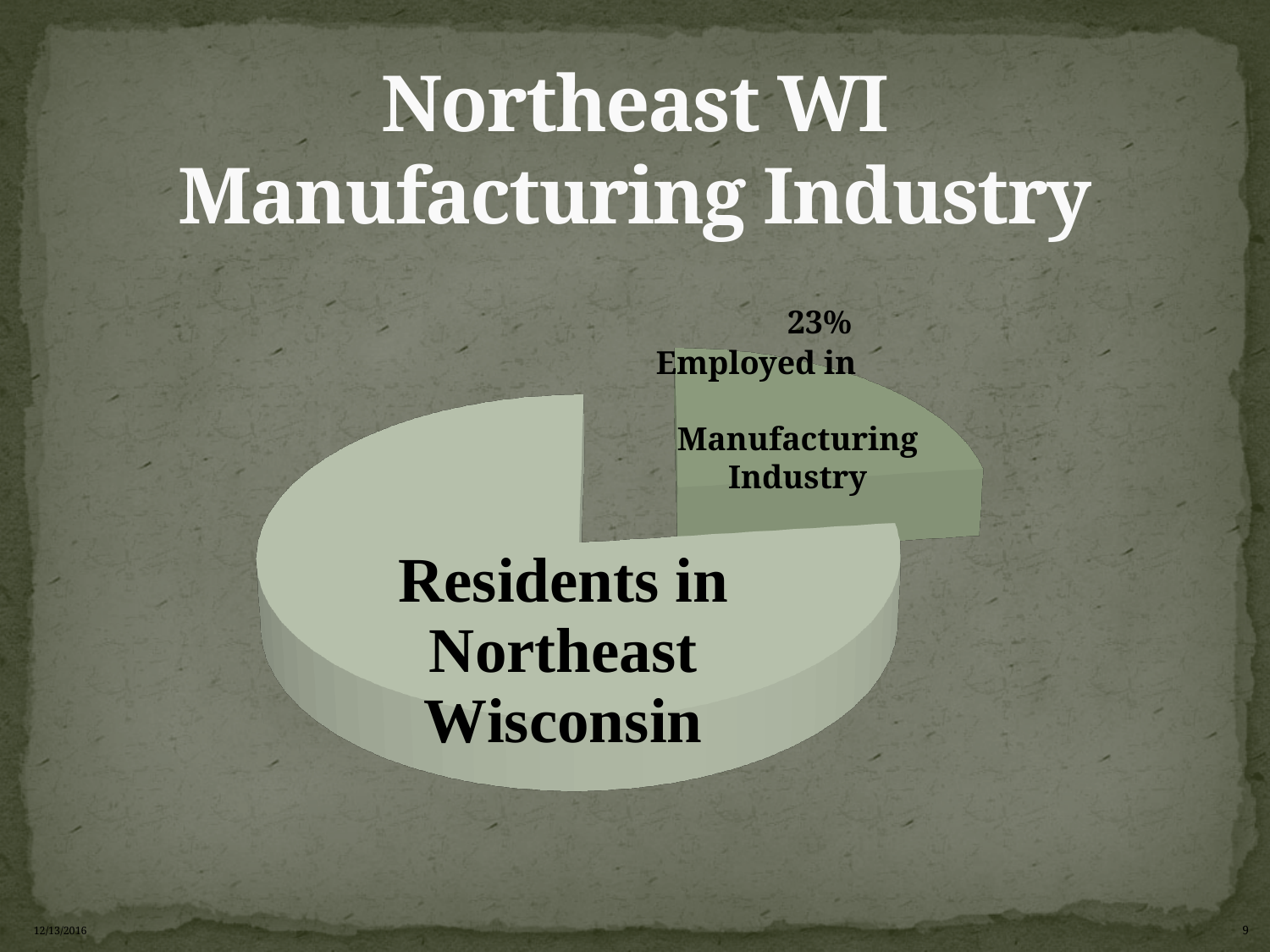
What percentage of the pie is labelled as Employed in Manufacturing Industry? 23% What is the title of the slide containing the pie chart? Northeast WI Manufacturing Industry What kind of chart is shown on the slide? pie chart Which slice of the pie chart is the smallest? Employed in Manufacturing Industry Which slice is larger: Residents in Northeast Wisconsin or Employed in Manufacturing Industry? Residents in Northeast Wisconsin Which slice of the pie chart is pulled out (exploded) from the rest of the pie? Employed in Manufacturing Industry How many slices does the pie chart have? 2 Which slice of the pie chart is the largest? Residents in Northeast Wisconsin